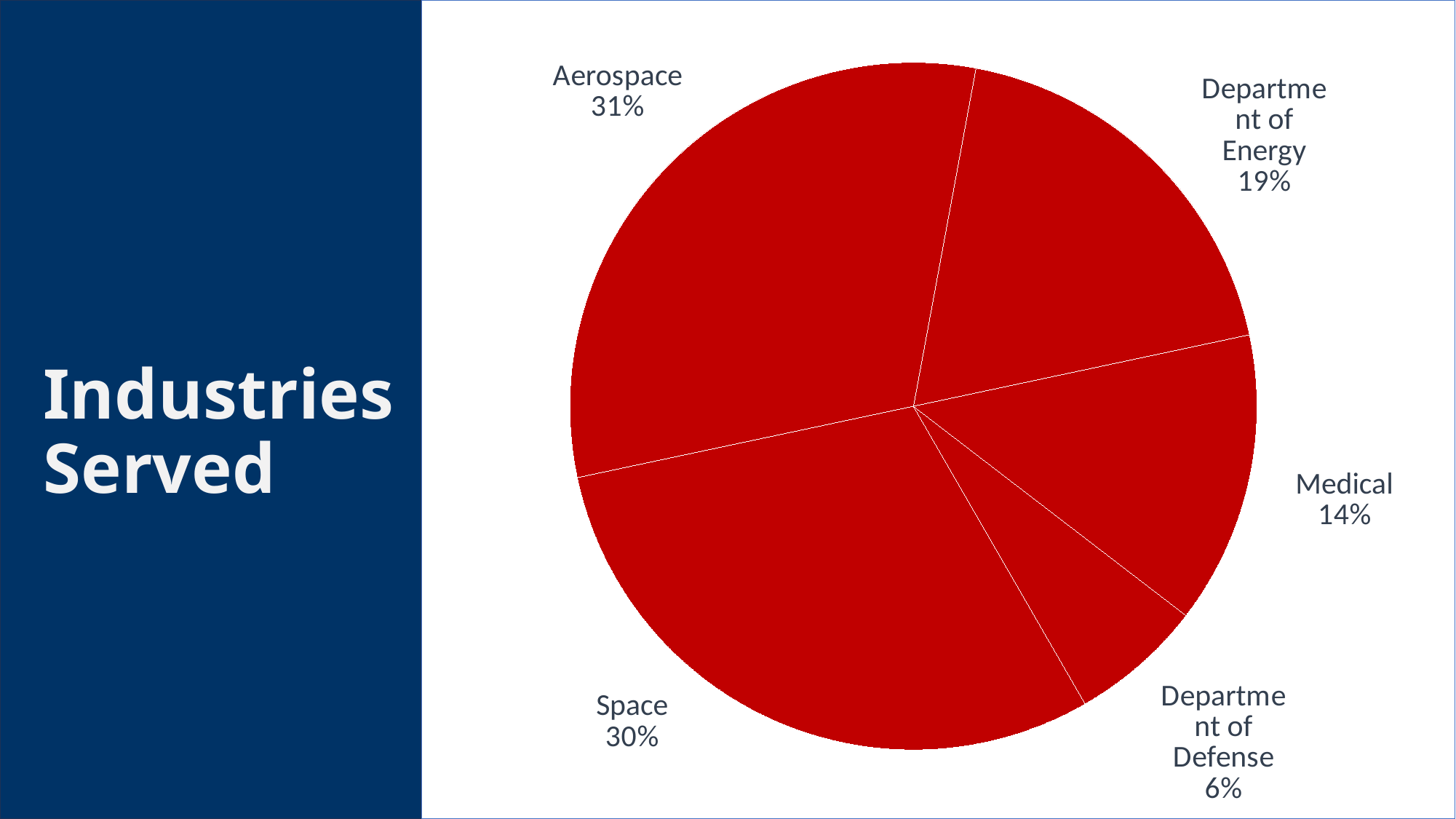
Which industry has the smallest share of the pie? Department of Defense What share of the pie does Medical represent? 14% What share of the pie does Department of Energy represent? 19% What is the difference in percentage points between the Department of Energy and Medical shares? 5 Which industry has the largest share of the pie? Aerospace What share of the pie does Department of Defense represent? 6% What kind of chart is shown on the slide? Pie chart What is the title shown on the slide next to the chart? Industries Served Which is larger, the Medical share or the Department of Defense share? Medical How many slices does the pie chart have? 5